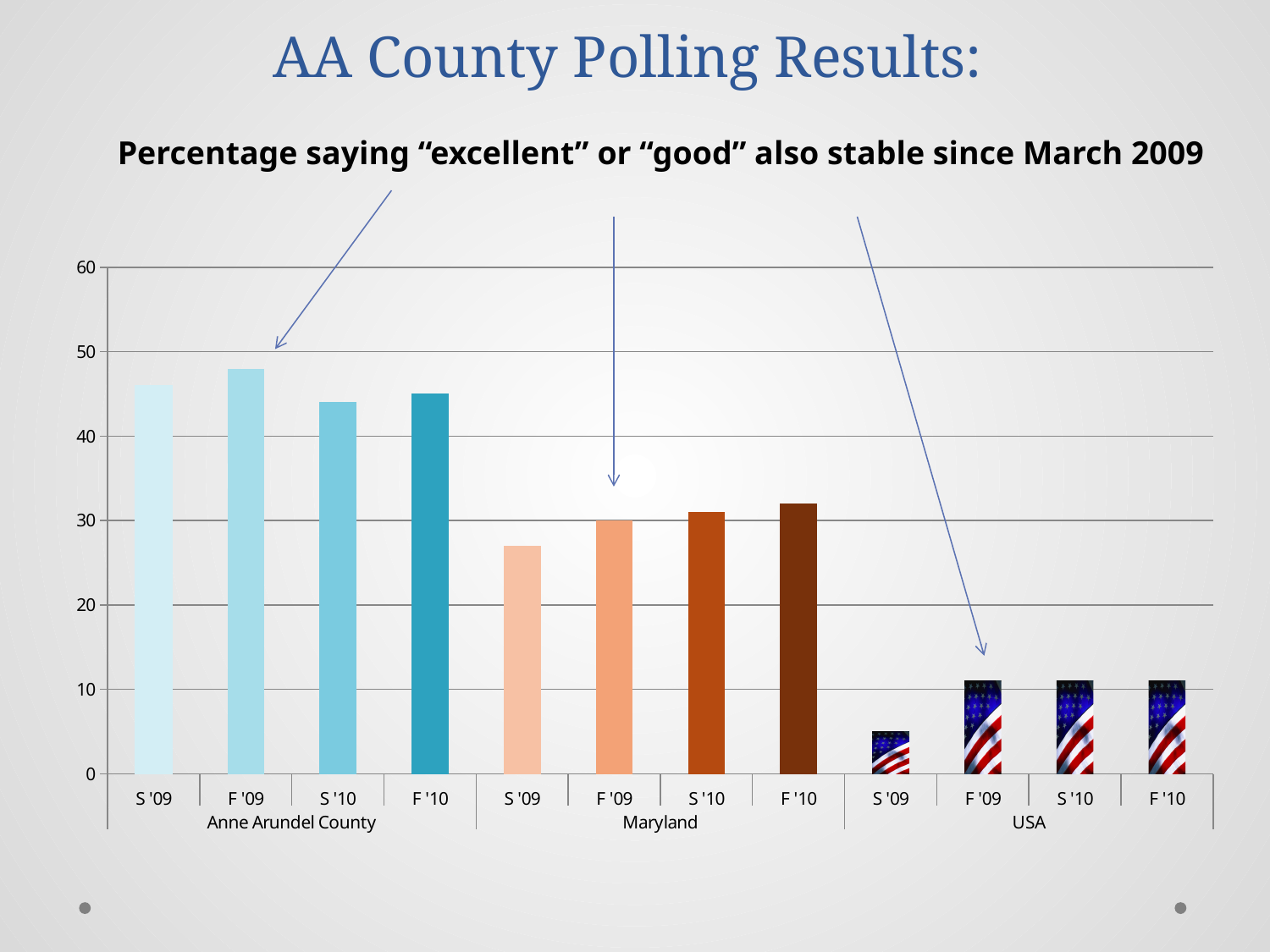
How many regions (groups) are shown along the x axis of the chart? 3 How many bars are plotted in the chart in total? 12 Which is larger: S '10 for Anne Arundel County or F '10 for Maryland? S '10 for Anne Arundel County What is the title of the slide containing the chart? AA County Polling Results: Within the Anne Arundel County group, which is larger: F '09 or S '10? F '09 Is the value for S '09 in the USA group greater or less than 10? less Which bar is the highest in the chart? F '09, Anne Arundel County What kind of chart is shown on the slide? bar chart Is the value for S '09 in the Maryland group greater or less than 30? less Do the Maryland bars rise or fall from S '09 to F '10? rise Is the value for F '09 in the Anne Arundel County group greater or less than 40? greater Which bar is the lowest in the chart? S '09, USA